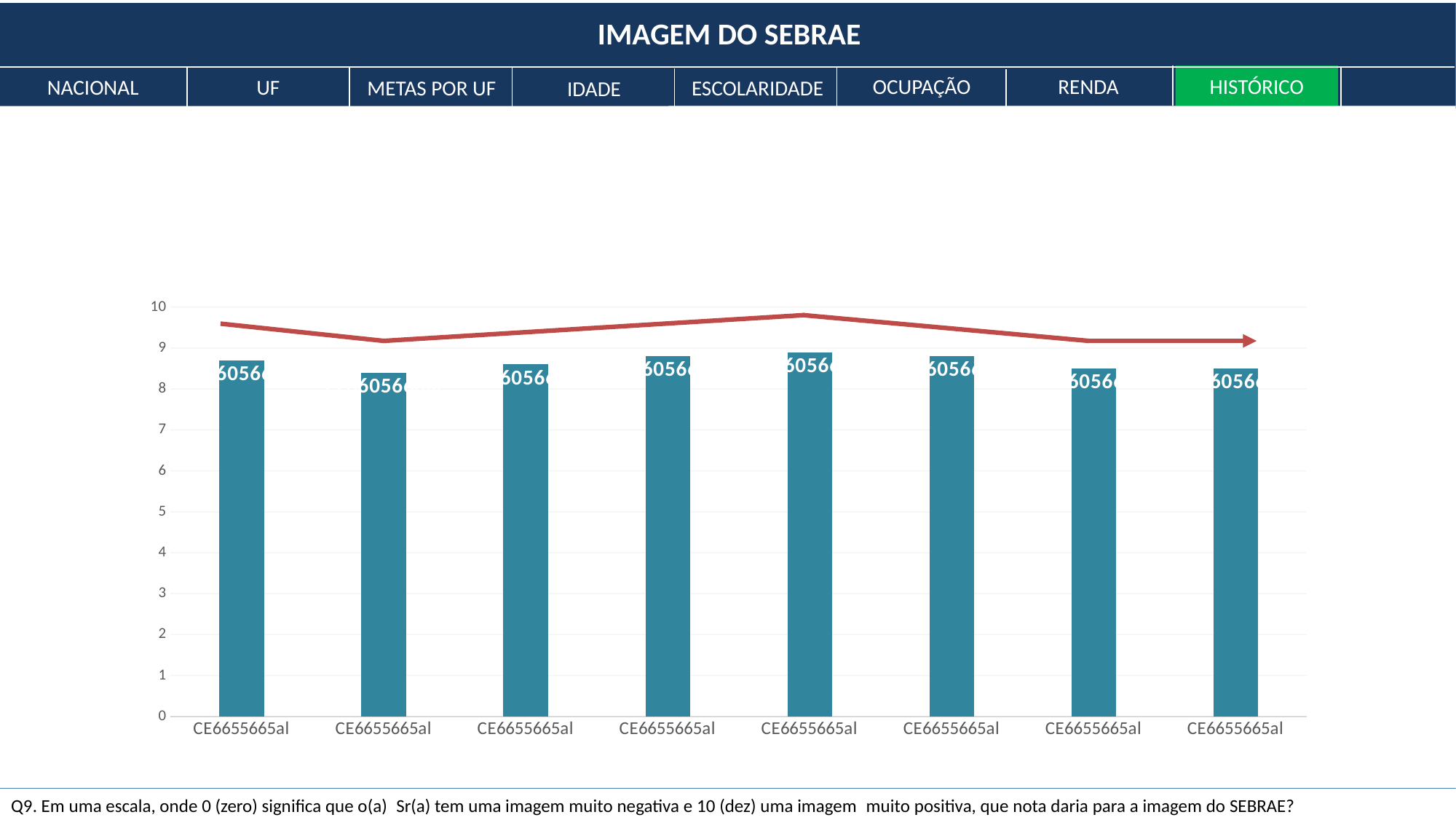
Is the value of the first bar from the left greater or less than 8? greater What kind of chart is shown on the slide? bar chart At which bar position does the red line reach its highest point? the fifth bar Which bar is the shortest in the chart, counting from the left? the second bar What colour are the bars in the chart? teal blue Is the value of the last bar on the right greater or less than 8? greater What is the highest value shown on the vertical axis? 10 Which is taller, the fifth bar or the second bar from the left? the fifth bar Which bar is the tallest in the chart, counting from the left? the fifth bar Is the value of the fifth bar from the left greater or less than 9? less How many bars are plotted in the chart? 8